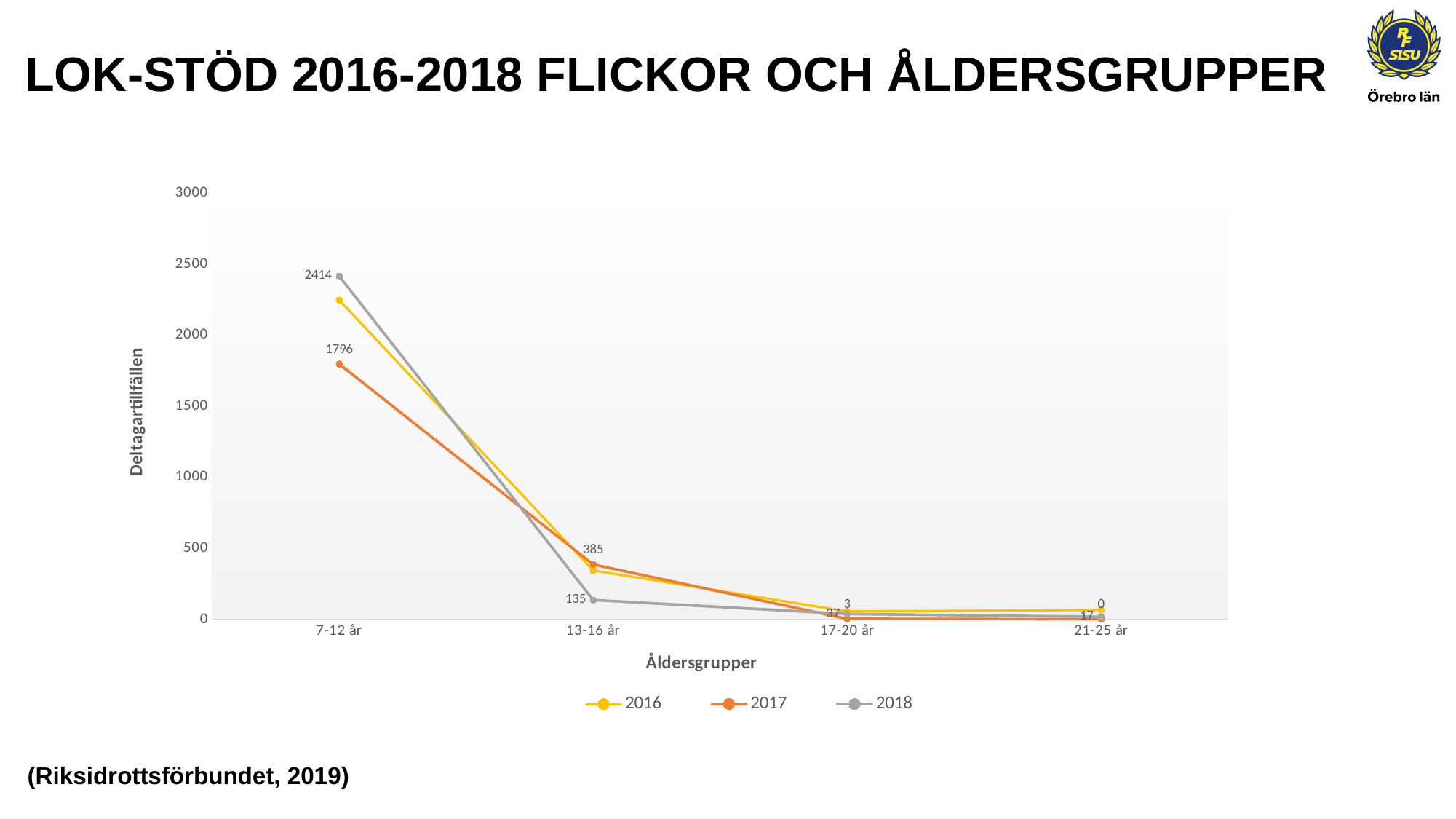
What is the value for 2018 in the 13-16 år age group? 135 In the 7-12 år age group, which series has the larger value, 2017 or 2018? 2018 For the 2018 series, what is the difference between the 7-12 år and 13-16 år values? 2279 Is the value for 2016 in the 7-12 år age group greater or less than 2000? greater Do the values for the 2018 series rise or fall from 7-12 år to 21-25 år? fall What kind of chart is shown on the slide? line chart How many series does the legend list? 3 What is the difference between the 2018 and 2017 values for the 7-12 år age group? 618 Which age group has the highest value for the 2018 series? 7-12 år How many age groups are shown on the x axis? 4 What is the value for 2018 in the 7-12 år age group? 2414 What is the value for 2017 in the 7-12 år age group? 1796